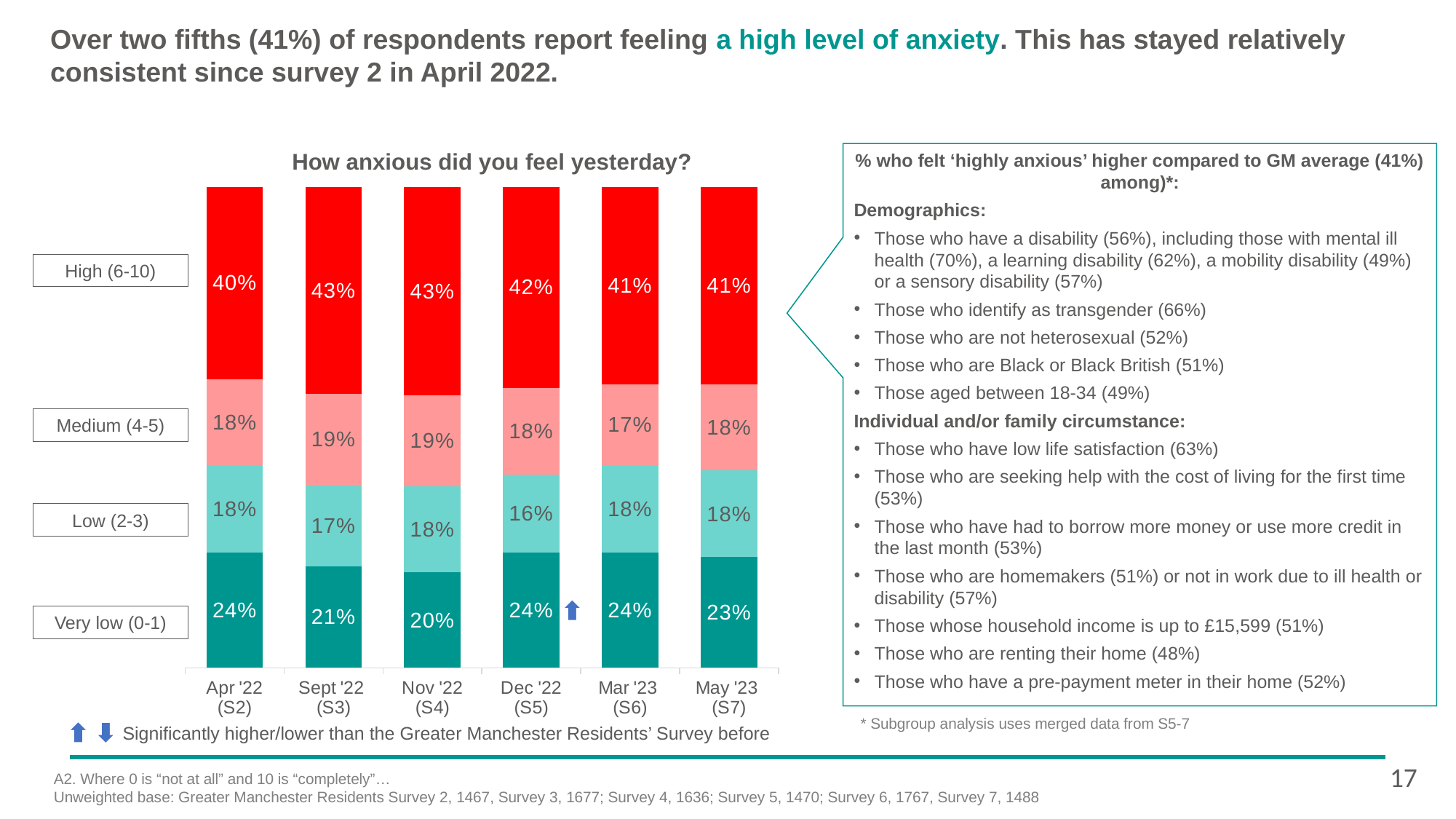
What is the Very low (0-1) value for Nov '22 (S4)? 20% What is the total of the stacked bar for May '23 (S7)? 100% How many survey waves are shown on the x axis of the chart? 6 What percentage of respondents reported High (6-10) anxiety in Apr '22 (S2)? 40% In which survey wave is the High (6-10) value lowest? Apr '22 (S2) What type of chart is used to show 'How anxious did you feel yesterday?' Stacked bar chart What is the Low (2-3) value for Dec '22 (S5)? 16% In which survey wave is the Very low (0-1) value lowest? Nov '22 (S4) Which is larger: the Very low (0-1) value in Apr '22 (S2) or in Sept '22 (S3)? Apr '22 (S2) What is the Medium (4-5) value for Mar '23 (S6)? 17% How many anxiety categories (series) are stacked in each bar? 4 What is the difference in percentage points between the High (6-10) value in Sept '22 (S3) and in Apr '22 (S2)? 3 percentage points